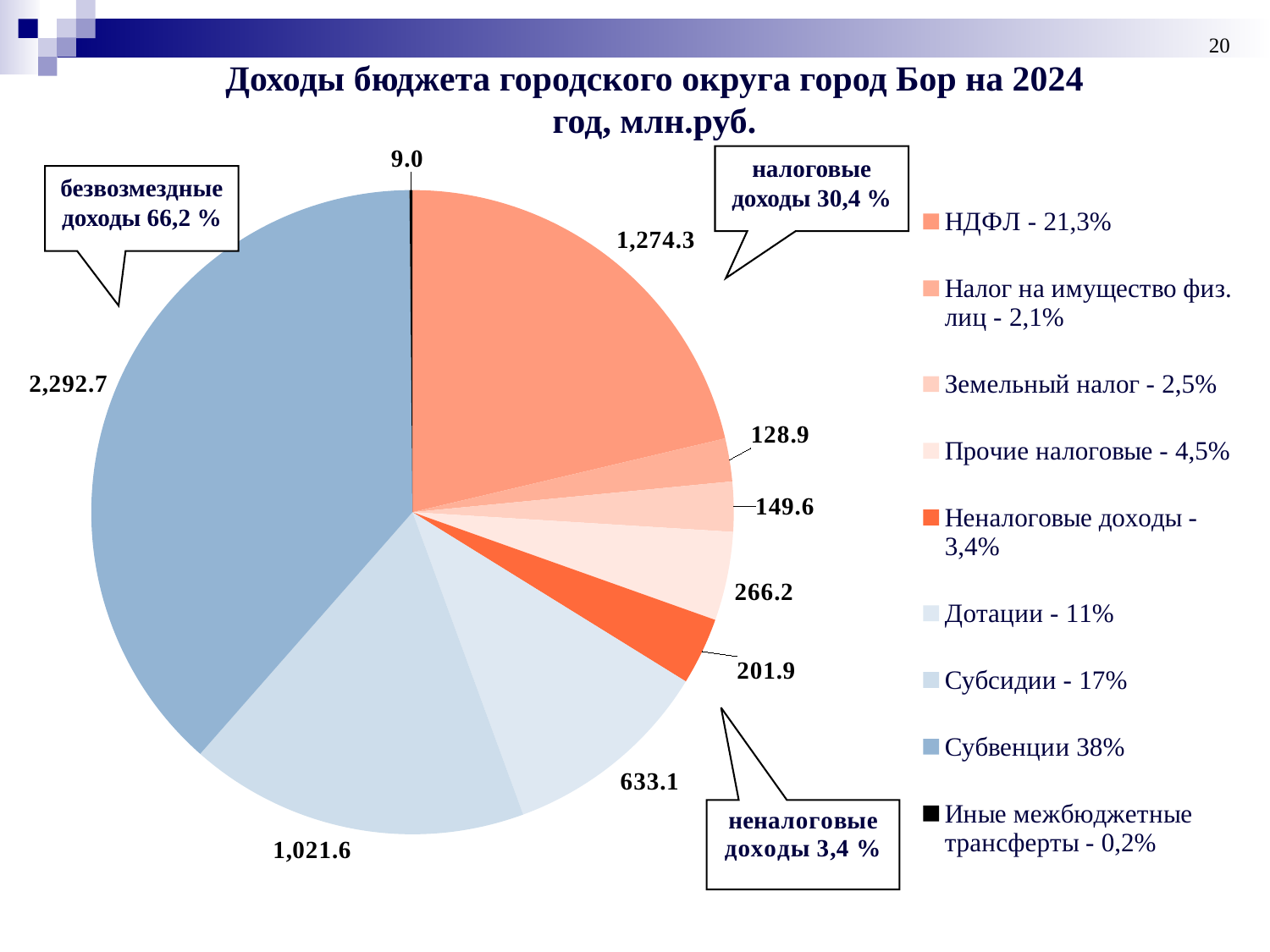
What is the value for Неналоговые доходы? 201.9 Which is larger, the value for Земельный налог or the value for Налог на имущество физ. лиц? Земельный налог What is the value for Дотации? 633.1 Which category has the smallest slice of the pie? Иные межбюджетные трансферты What is the value for Субвенции? 2,292.7 What is the title of the chart? Доходы бюджета городского округа город Бор на 2024 год, млн.руб. What share of the pie does Субсидии represent according to the legend? 17% Which category has the largest slice of the pie? Субвенции How many categories does the legend list? 9 What type of chart is shown on the slide? pie chart What is the value for НДФЛ? 1,274.3 What is the difference between the values for Субвенции and Субсидии? 1,271.1